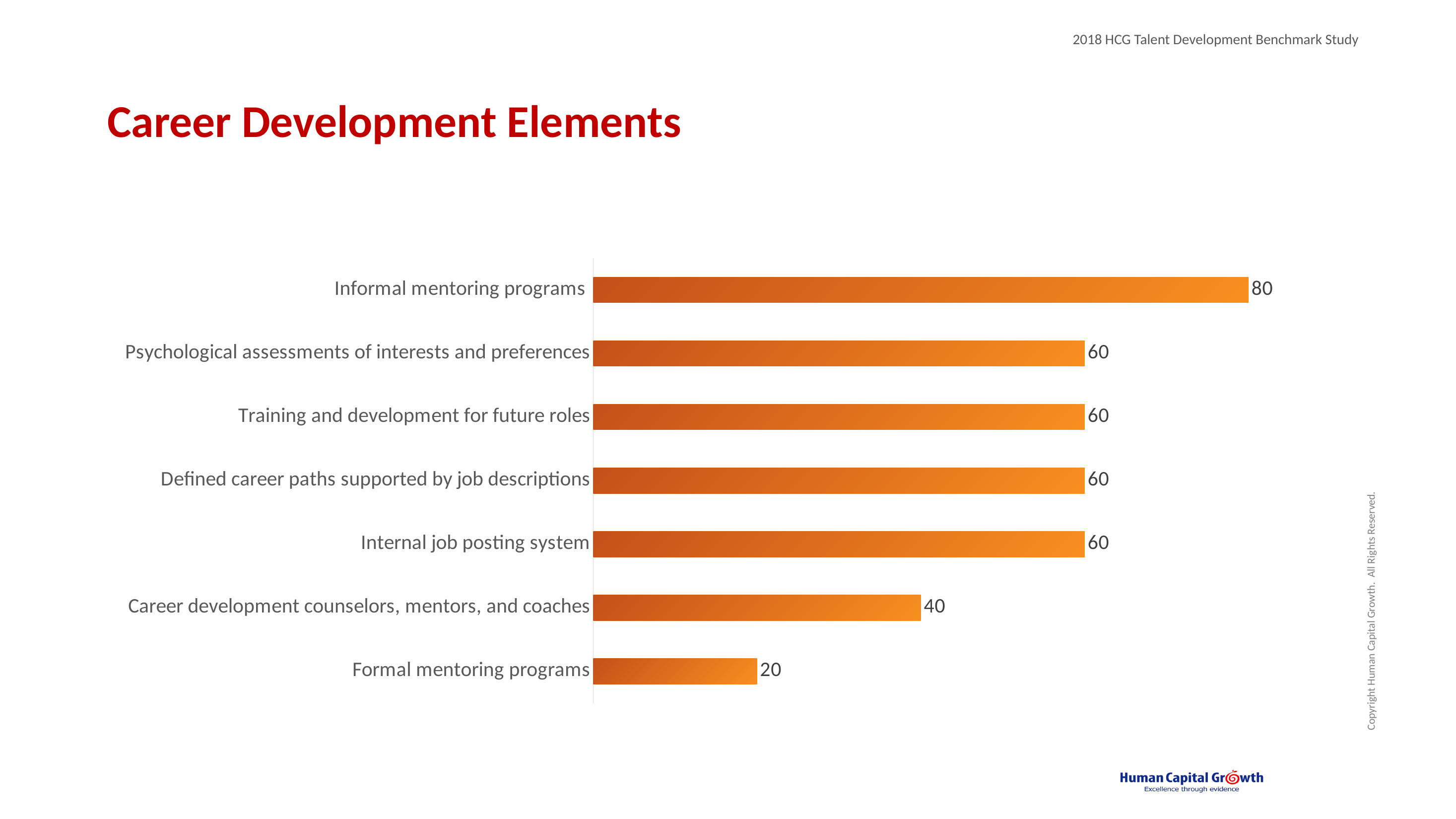
What kind of chart is shown on the slide? Bar chart What is the value for Career development counselors, mentors, and coaches? 40 What is the value for Informal mentoring programs? 80 What is the value for Internal job posting system? 60 Which is larger: the value for Informal mentoring programs or the value for Psychological assessments of interests and preferences? Informal mentoring programs What is the difference between the values for Informal mentoring programs and Formal mentoring programs? 60 What is the difference between the values for Training and development for future roles and Career development counselors, mentors, and coaches? 20 Which category has the highest value? Informal mentoring programs How many categories are shown in the chart? 7 What is the title of the slide containing the chart? Career Development Elements Which category has the lowest value? Formal mentoring programs What is the value for Formal mentoring programs? 20